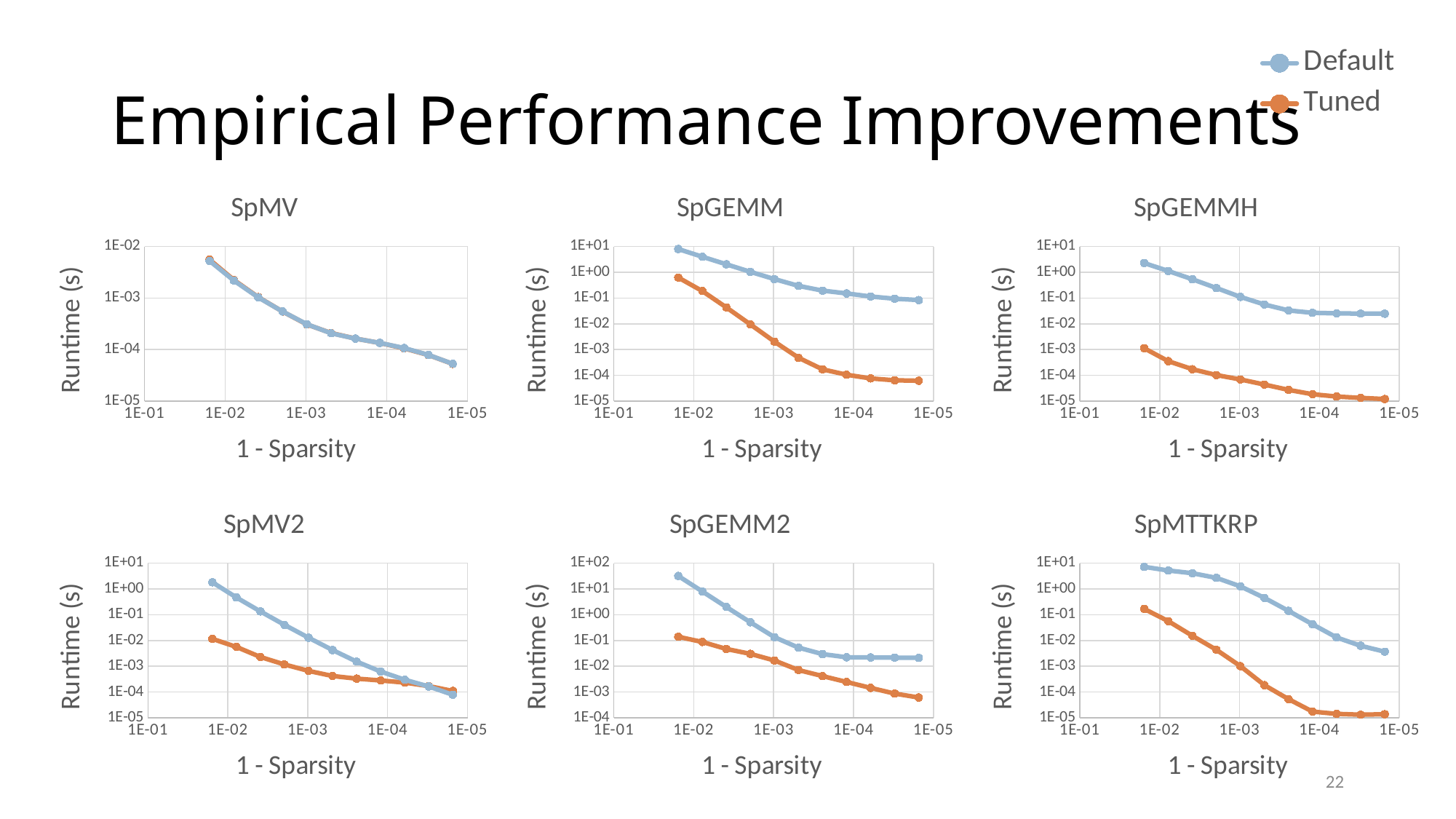
What kind of chart is the SpGEMM chart? line chart In the SpGEMM chart, does the Default runtime rise or fall moving left to right along the x axis? fall In the SpGEMM chart, at 1 - Sparsity = 1E-03, which series has the larger runtime, Default or Tuned? Default In the SpGEMM chart, is the Tuned runtime at 1 - Sparsity = 1E-02 greater or less than 1E+00? less In the SpMV2 chart, at 1 - Sparsity = 1E-02, which series has the larger runtime, Default or Tuned? Default How many series does the legend list? 2 What is the x-axis label on the SpMTTKRP chart? 1 - Sparsity What are the two series named in the legend? Default and Tuned How many charts are shown on the slide? 6 In the SpMTTKRP chart, does the Tuned runtime rise or fall moving left to right along the x axis? fall